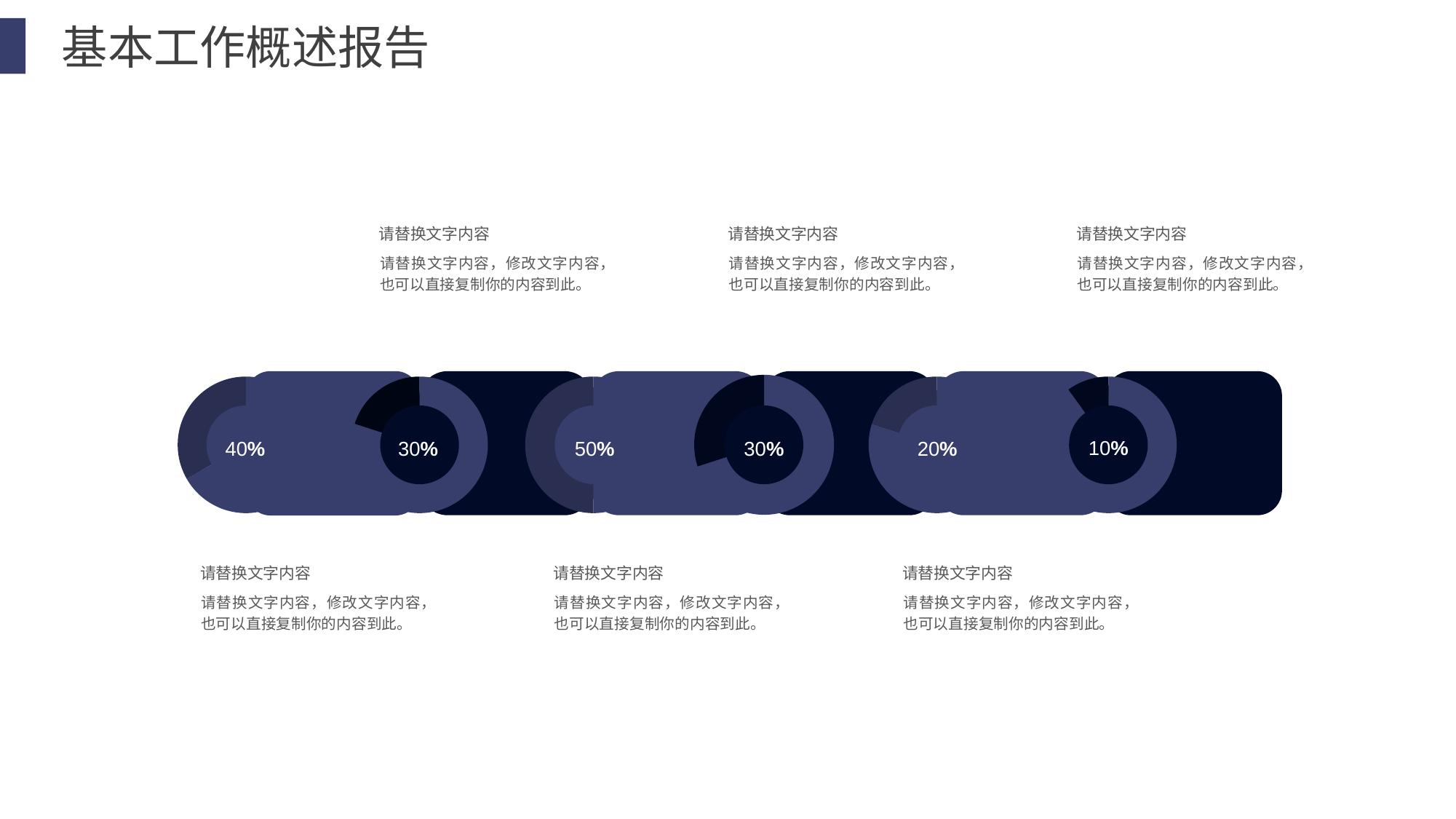
What percentage is shown in the last (rightmost) donut chart? 10% What percentage is shown in the third donut chart from the left? 50% What is the difference between the percentage in the first donut chart and the percentage in the last donut chart? 30% What percentage is shown in the first (leftmost) donut chart? 40% What kind of chart is used to display the percentages on this slide? Donut chart What percentage is shown in the fifth donut chart from the left? 20% What is the title of the slide containing the donut charts? 基本工作概述报告 What percentage is shown in the second donut chart from the left? 30% Which donut chart shows the highest percentage? The third from the left (50%) How many donut charts are shown on the slide? 6 Which donut chart shows the lowest percentage? The rightmost (10%) Which is larger, the percentage in the first donut chart or the percentage in the fifth donut chart? The first (40%)